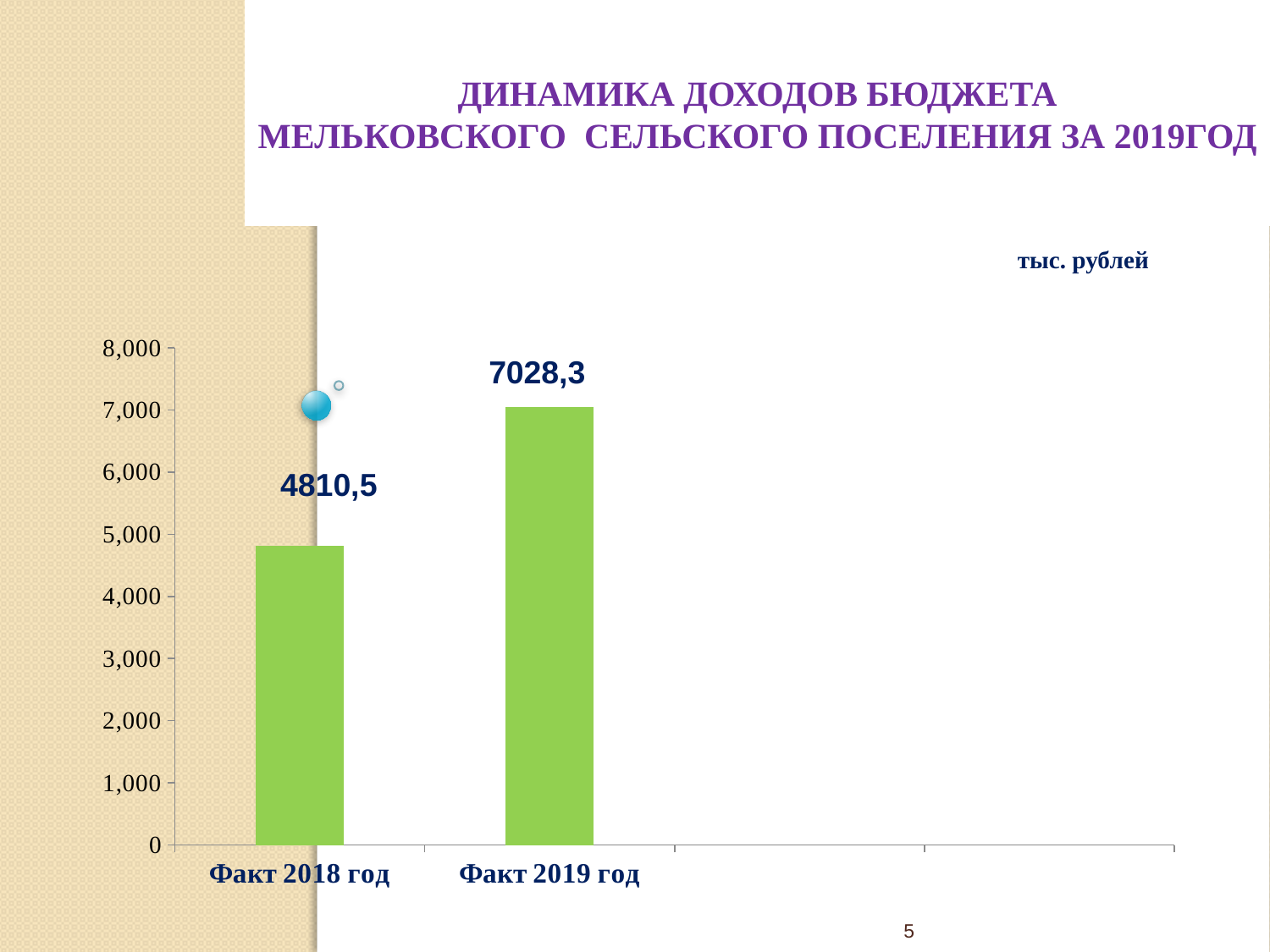
How many categories are shown on the chart? 2 What is the value for Факт 2018 год? 4810,5 What is the value for Факт 2019 год? 7028,3 Which category has the lowest value? Факт 2018 год Which category has the highest value? Факт 2019 год What is the difference between the values for Факт 2019 год and Факт 2018 год? 2217,8 Do the values rise or fall from Факт 2018 год to Факт 2019 год? rise Is the value for Факт 2018 год greater or less than 5,000? less Which is larger, the value for Факт 2018 год or Факт 2019 год? Факт 2019 год What kind of chart is shown on the slide? bar chart Is the value for Факт 2019 год greater or less than 7,000? greater What unit is indicated for the chart values? тыс. рублей